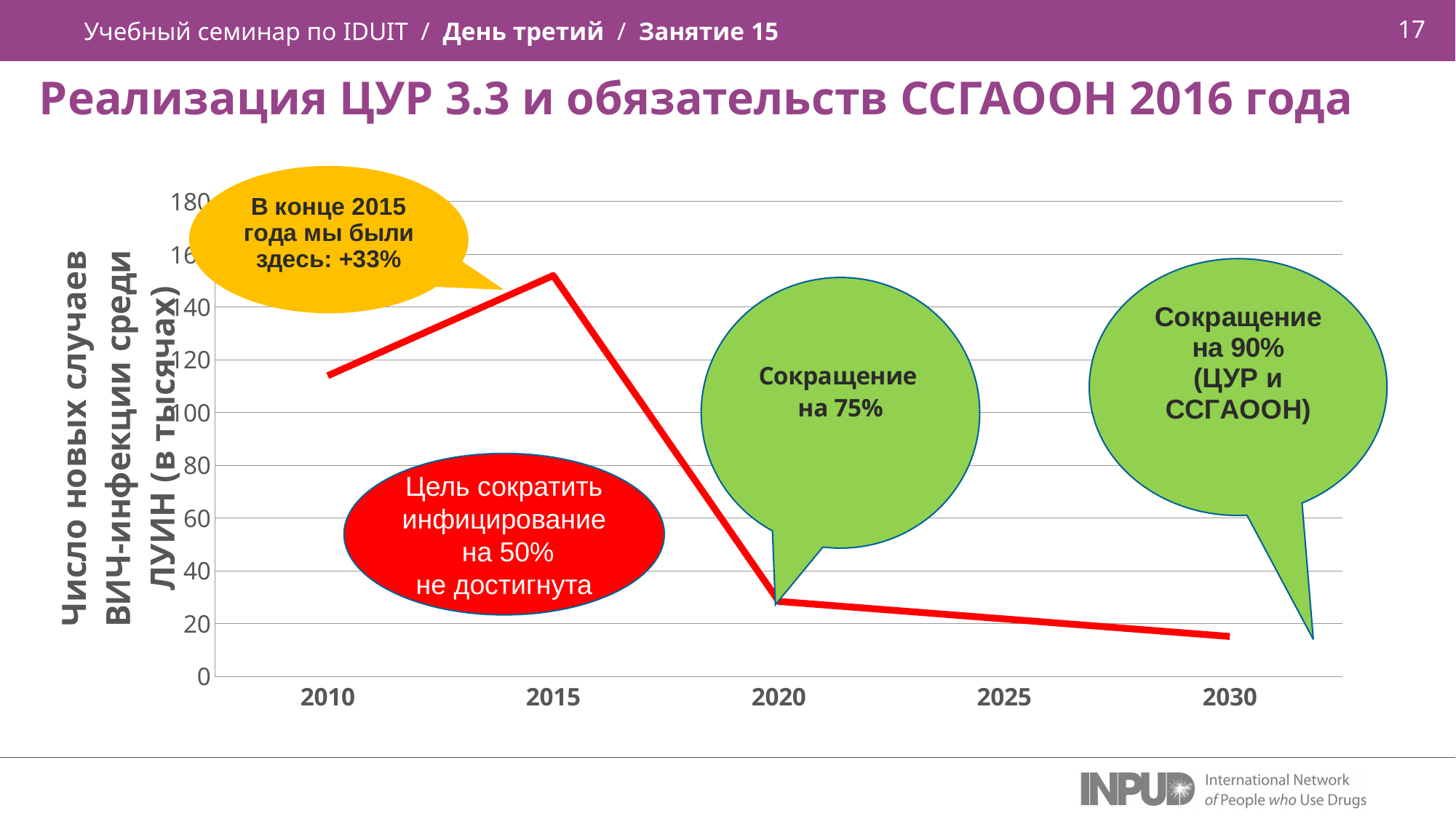
What kind of chart is shown on the slide? line chart Is the value for 2010 greater or less than 100? greater Which is larger, the value for 2010 or the value for 2020? 2010 What percentage reduction does the green callout pointing at 2020 state? Сокращение на 75% Is the value for 2030 greater or less than 20? less What is the label of the y axis? Число новых случаев ВИЧ-инфекции среди ЛУИН (в тысячах) How many year labels are shown on the x axis? 5 Does the line rise or fall between 2015 and 2030? fall Is the value for 2015 greater or less than 140? greater In which year does the line reach its highest value? 2015 In which year does the line reach its lowest value? 2030